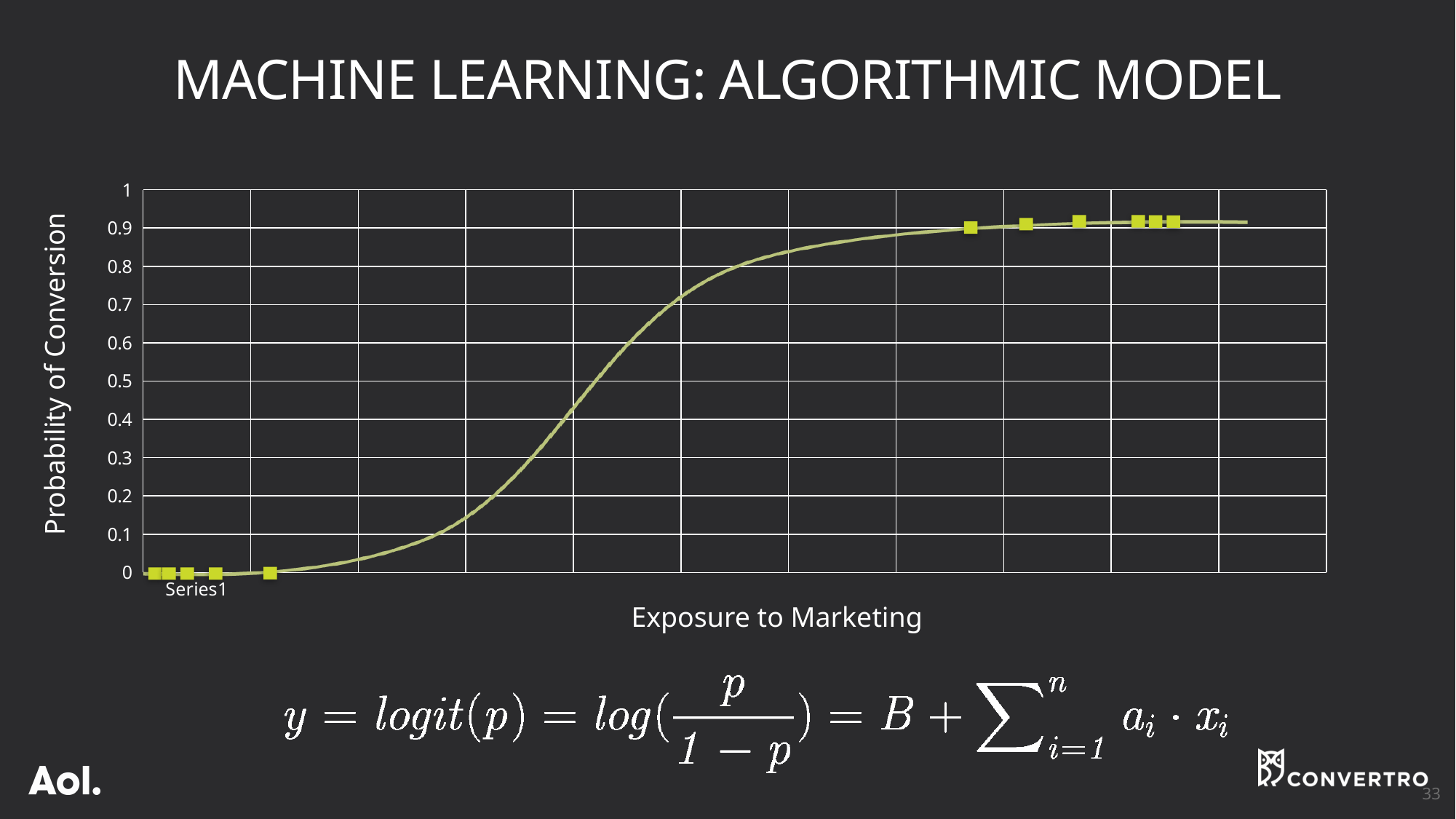
Is the value of the rightmost marker on the curve greater or less than 0.5? greater What kind of chart is shown on the slide? line chart What is the title of the y axis of the chart? Probability of Conversion Is the value of the leftmost marker on the curve greater or less than 0.1? less Which is larger, the value of the leftmost marker or the value of the rightmost marker on the curve? the rightmost marker What is the highest tick value shown on the y axis? 1 Is the value of the rightmost marker on the curve greater or less than 0.8? greater How many square markers are plotted on the curve? 11 Do the plotted values rise or fall as exposure to marketing increases along the x axis? rise What is the title of the x axis of the chart? Exposure to Marketing